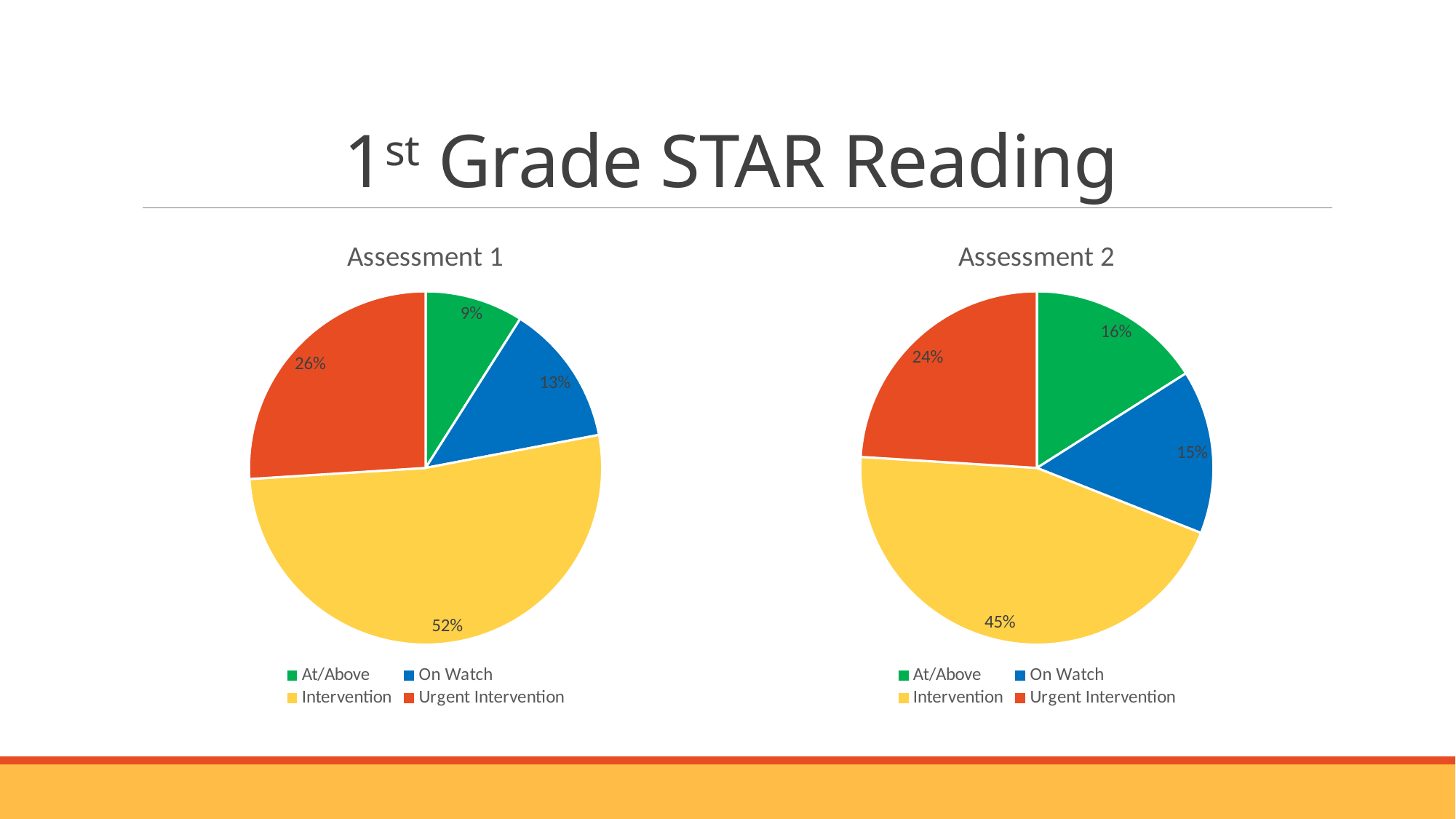
In the Assessment 2 chart, what percentage is shown for On Watch? 15% In the Assessment 2 chart, which category has the largest share? Intervention In the Assessment 2 chart, what percentage is shown for At/Above? 16% In the Assessment 1 chart, which category has the largest share? Intervention In the Assessment 1 chart, which category has the smallest share? At/Above In the Assessment 1 chart, what percentage is shown for Urgent Intervention? 26% What type of chart is used for Assessment 1? Pie chart How many slices does the Assessment 2 pie chart have? 4 In the Assessment 1 chart, what colour represents Urgent Intervention? Red What is the difference between the Intervention share in Assessment 1 and the Intervention share in Assessment 2? 7% Is the At/Above share larger in the Assessment 1 chart or the Assessment 2 chart? Assessment 2 In the Assessment 1 chart, what percentage is shown for Intervention? 52%